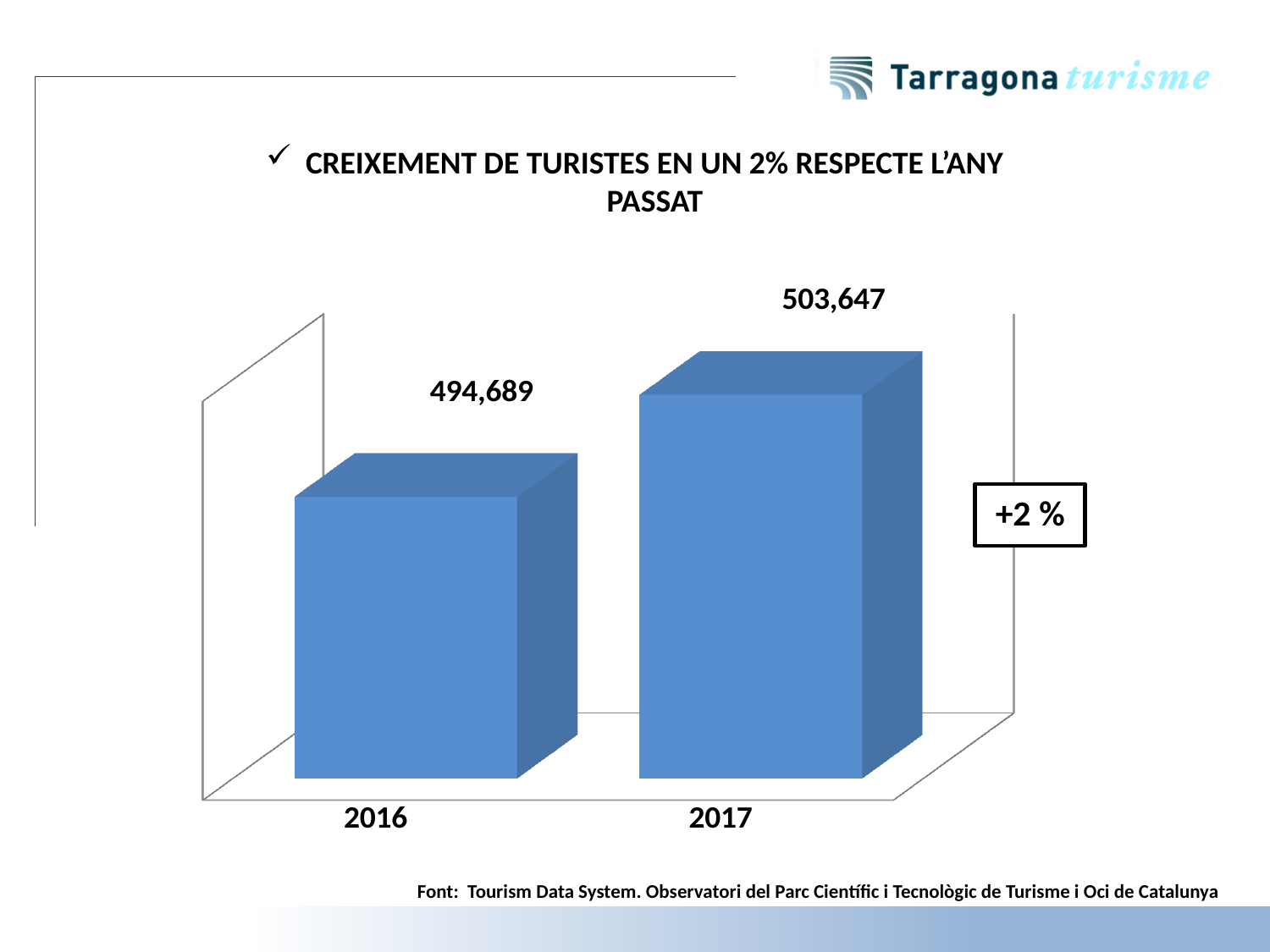
What kind of chart is shown on the slide? bar chart Do the values rise or fall from 2016 to 2017? rise What is the value for 2017? 503,647 What colour are the bars in the chart? blue How many years are shown on the chart? 2 Which year has the lowest value? 2016 Which is larger, the value for 2016 or the value for 2017? 2017 What percentage change is shown in the box next to the chart? +2 % What is the value for 2016? 494,689 Which year has the highest value? 2017 What is the difference between the 2017 and 2016 values? 8,958